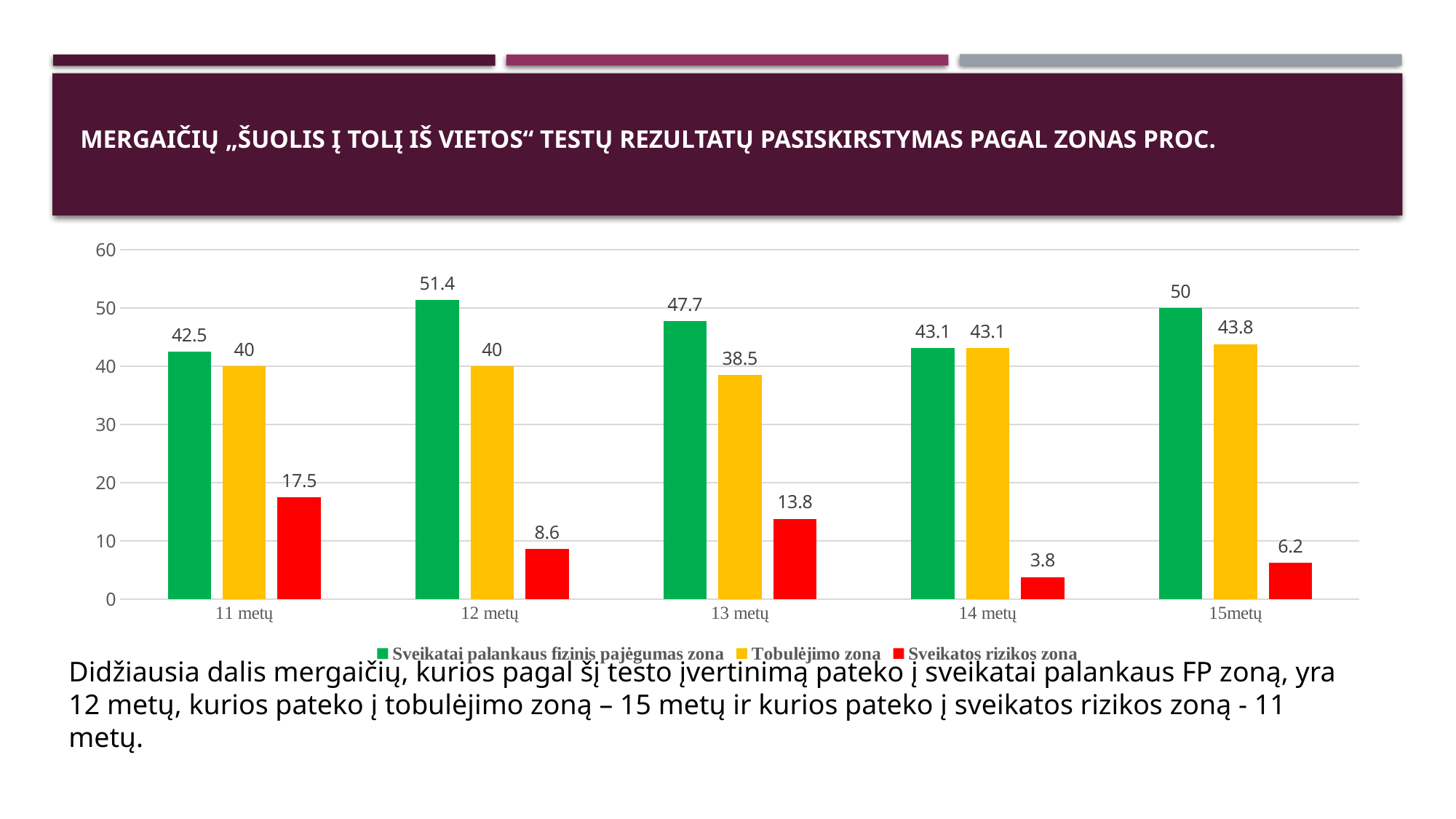
Is the value for 'Sveikatos rizikos zona' at 12 metų greater or less than 10? less What is the value for 'Sveikatos rizikos zona' at 14 metų? 3.8 Which is larger at 13 metų: 'Sveikatai palankaus fizinis pajėgumas zona' or 'Tobulėjimo zona'? Sveikatai palankaus fizinis pajėgumas zona Which colour represents 'Sveikatos rizikos zona' in the chart? red What is the value for 'Tobulėjimo zona' at 15metų? 43.8 Which age group has the lowest value for 'Tobulėjimo zona'? 13 metų What kind of chart is shown on the slide? bar chart What is the value for 'Sveikatai palankaus fizinis pajėgumas zona' at 12 metų? 51.4 What is the difference between the 'Sveikatai palankaus fizinis pajėgumas zona' value and the 'Tobulėjimo zona' value at 12 metų? 11.4 How many series does the legend list? 3 Which age group has the highest value for 'Sveikatos rizikos zona'? 11 metų How many age groups are shown on the x axis? 5